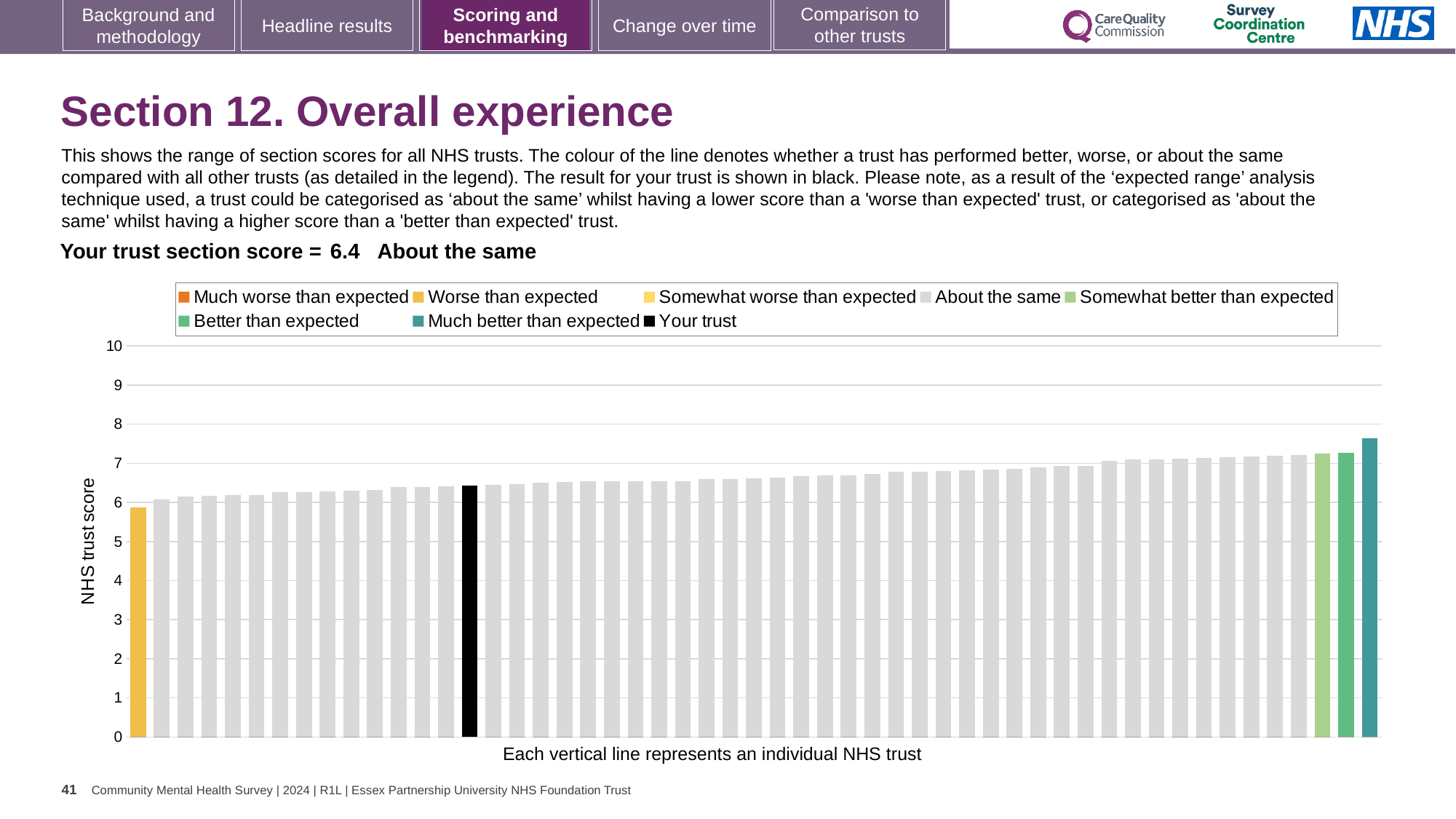
What colour is the bar representing your trust? black What is the section score for your trust shown on the slide? 6.4 Which legend category does the tallest bar in the chart belong to? Much better than expected What kind of chart is shown on the slide? bar chart Do the bar values rise or fall from left to right across the chart? rise How is your trust categorised compared with other trusts, according to the text above the chart? About the same What is the label on the vertical axis of the chart? NHS trust score Is the value of the tallest bar in the chart greater or less than 7? greater Which legend category does the shortest bar in the chart belong to? Worse than expected Is the value for your trust's bar greater or less than 5? greater How many entries does the chart legend list? 8 Is the value of the shortest bar in the chart greater or less than 7? less